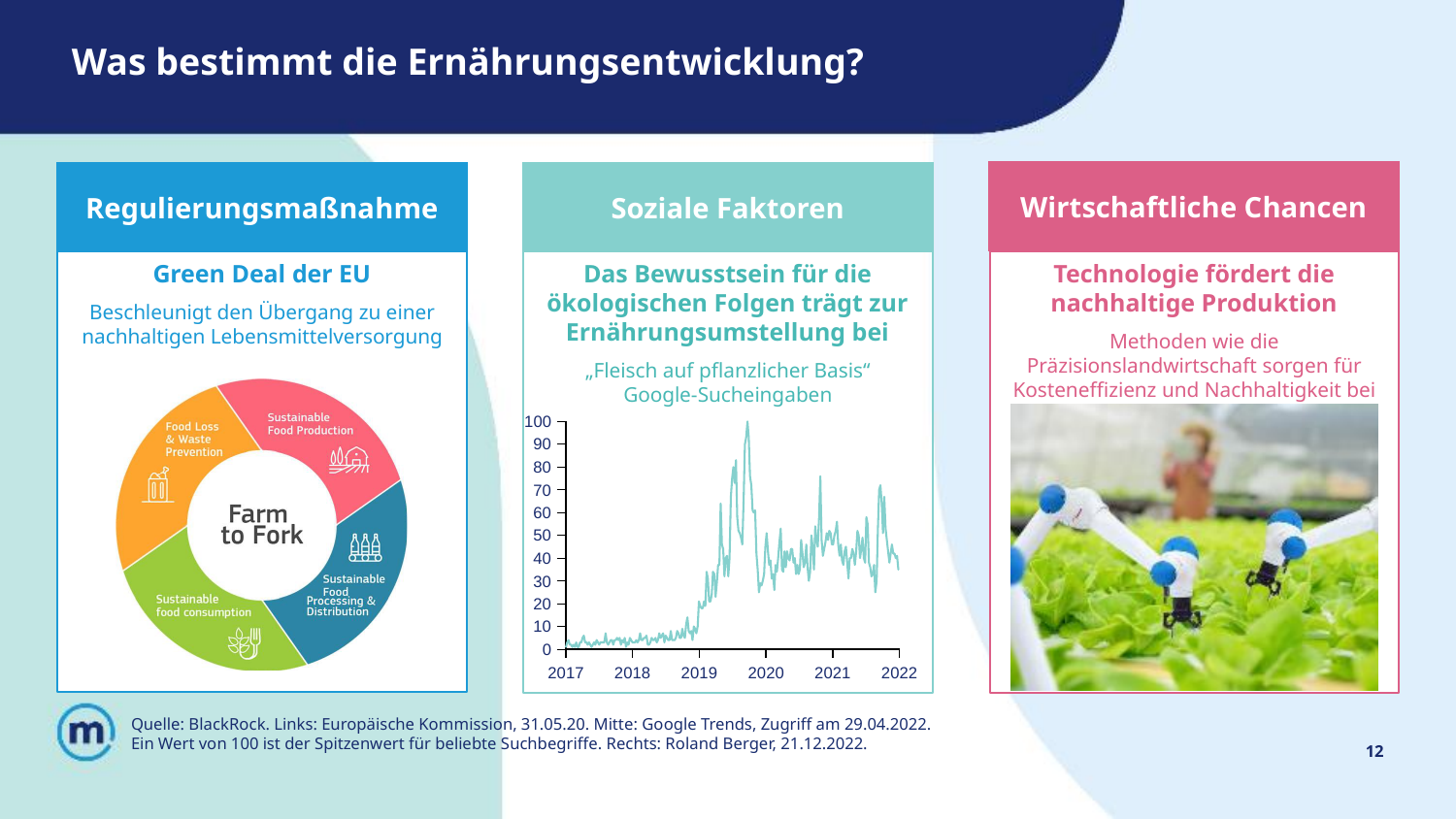
How many lines are plotted in the Google search chart? 1 In the Google search chart for "Fleisch auf pflanzlicher Basis", is the value at the start of 2017 greater or less than 10? less In the Google search chart, is the value at the start of 2018 greater or less than 20? less In the Google search chart, is the highest peak of the line greater or less than 90? greater In the Google search chart, is the value in 2017 higher or lower than the value in 2021? lower In the Google search chart, do the values generally rise or fall between 2017 and 2020? rise What is the maximum value shown on the y axis of the Google search chart? 100 How many year labels are shown on the x axis of the Google search chart? 6 What search term does the line chart in the middle panel track? "Fleisch auf pflanzlicher Basis" What kind of chart is shown in the middle panel under "Soziale Faktoren"? line chart